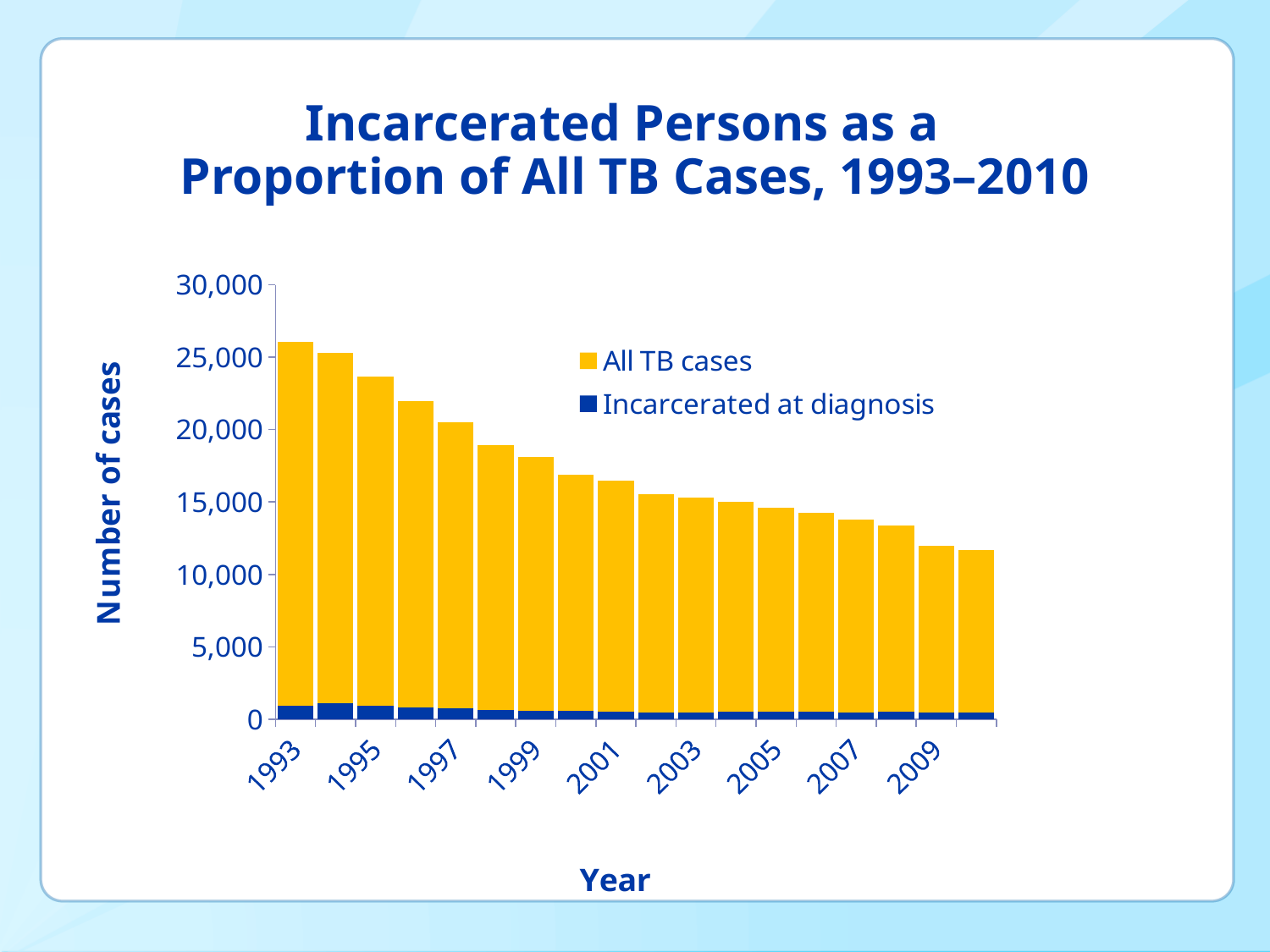
Is the total number of TB cases in 2009 greater or less than 15,000? less How many series does the legend list? 2 Is the total number of TB cases in 1993 greater or less than 25,000? greater Which year has the larger total number of TB cases, 1993 or 2009? 1993 How many yearly bars are plotted in the chart? 18 Is the total number of TB cases in 1999 greater or less than 20,000? less What is the label on the vertical axis of the chart? Number of cases What kind of chart is shown on the slide? Stacked bar chart Which year has the highest total number of TB cases? 1993 Do the total TB case values rise or fall from 1993 to 2010? Fall